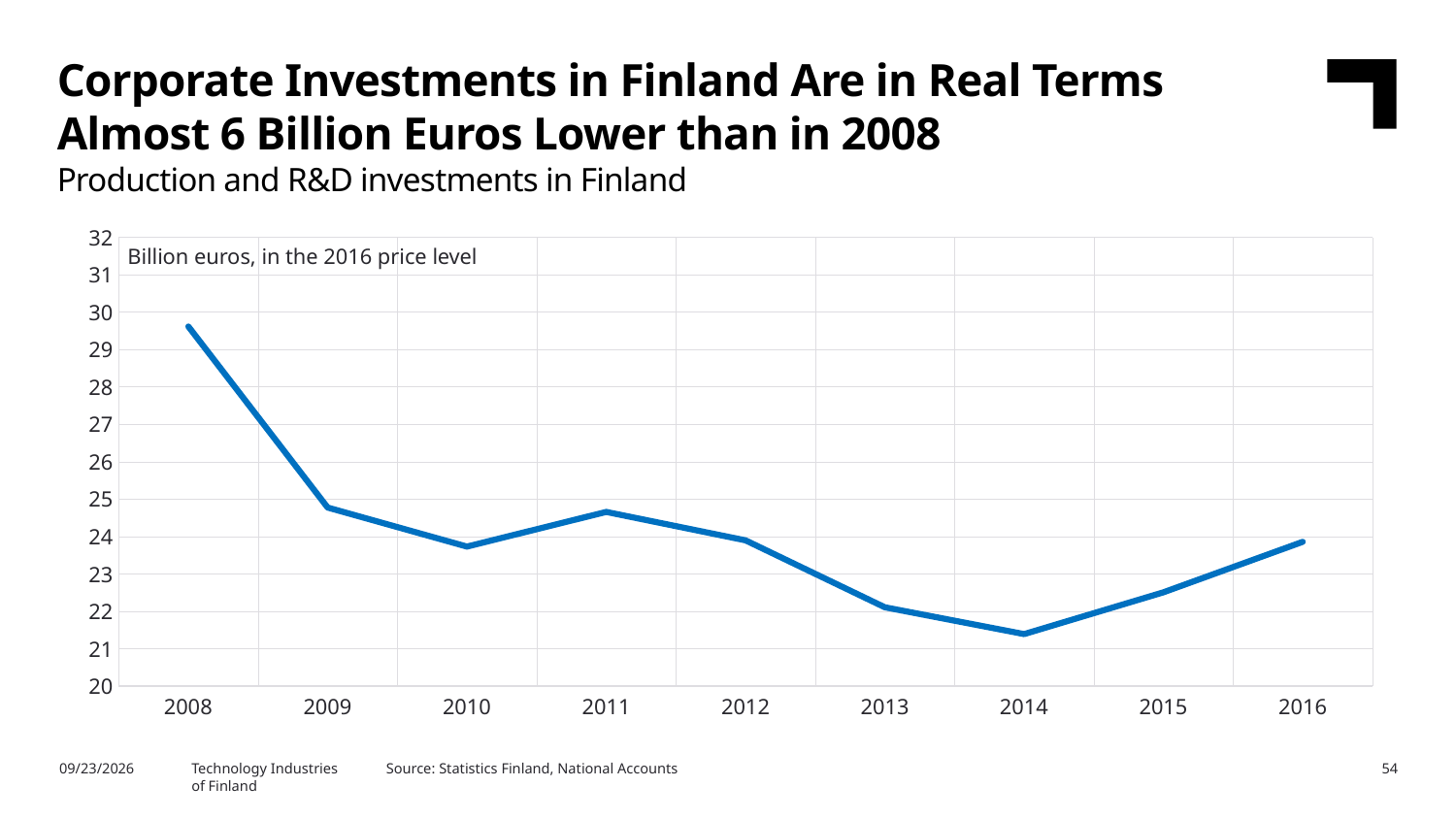
Is the value for 2014 greater or less than 22? less Do the values rise or fall from 2014 to 2016? Rise Which year has the larger value, 2008 or 2016? 2008 What kind of chart is shown on the slide? Line chart Is the value for 2009 greater or less than 24? greater Is the value for 2013 greater or less than 23? less What unit is stated in the label inside the chart area? Billion euros, in the 2016 price level In which year is the value of production and R&D investments lowest? 2014 In which year is the value of production and R&D investments highest? 2008 Which year has the larger value, 2009 or 2010? 2009 How many years are plotted on the x axis of the chart? 9